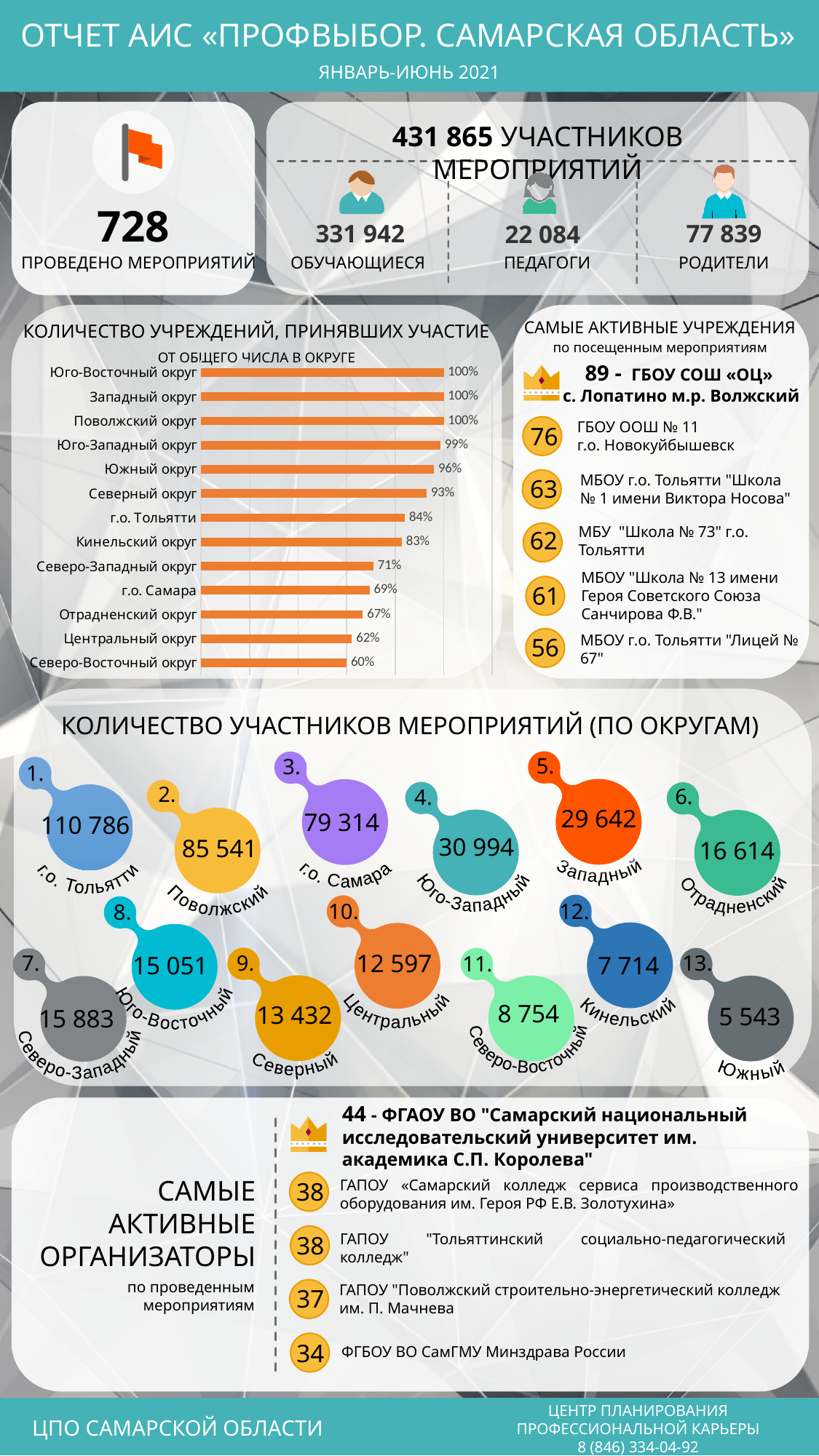
In the chart "КОЛИЧЕСТВО УЧРЕЖДЕНИЙ, ПРИНЯВШИХ УЧАСТИЕ", do the values rise or fall from the top bar to the bottom bar? Fall In the chart "КОЛИЧЕСТВО УЧРЕЖДЕНИЙ, ПРИНЯВШИХ УЧАСТИЕ", how many districts have a value of 100%? 3 How many districts are shown in the chart "КОЛИЧЕСТВО УЧРЕЖДЕНИЙ, ПРИНЯВШИХ УЧАСТИЕ"? 13 In the chart "КОЛИЧЕСТВО УЧРЕЖДЕНИЙ, ПРИНЯВШИХ УЧАСТИЕ", which district has the lowest value? Северо-Восточный округ In the chart "КОЛИЧЕСТВО УЧАСТНИКОВ МЕРОПРИЯТИЙ (ПО ОКРУГАМ)", what is the difference between Кинельский and Южный? 2 171 In the chart "КОЛИЧЕСТВО УЧРЕЖДЕНИЙ, ПРИНЯВШИХ УЧАСТИЕ", what is the value for г.о. Самара? 69% In the chart "КОЛИЧЕСТВО УЧАСТНИКОВ МЕРОПРИЯТИЙ (ПО ОКРУГАМ)", which district has the highest number of participants? г.о. Тольятти What kind of chart is "КОЛИЧЕСТВО УЧРЕЖДЕНИЙ, ПРИНЯВШИХ УЧАСТИЕ"? Bar chart In the chart "КОЛИЧЕСТВО УЧРЕЖДЕНИЙ, ПРИНЯВШИХ УЧАСТИЕ", which is larger: г.о. Тольятти or Северо-Западный округ? г.о. Тольятти In the chart "КОЛИЧЕСТВО УЧРЕЖДЕНИЙ, ПРИНЯВШИХ УЧАСТИЕ", what is the value for Южный округ? 96% In the chart "КОЛИЧЕСТВО УЧРЕЖДЕНИЙ, ПРИНЯВШИХ УЧАСТИЕ", what is the difference between Кинельский округ and Центральный округ? 21% In the chart "КОЛИЧЕСТВО УЧАСТНИКОВ МЕРОПРИЯТИЙ (ПО ОКРУГАМ)", what is the value for Поволжский? 85 541